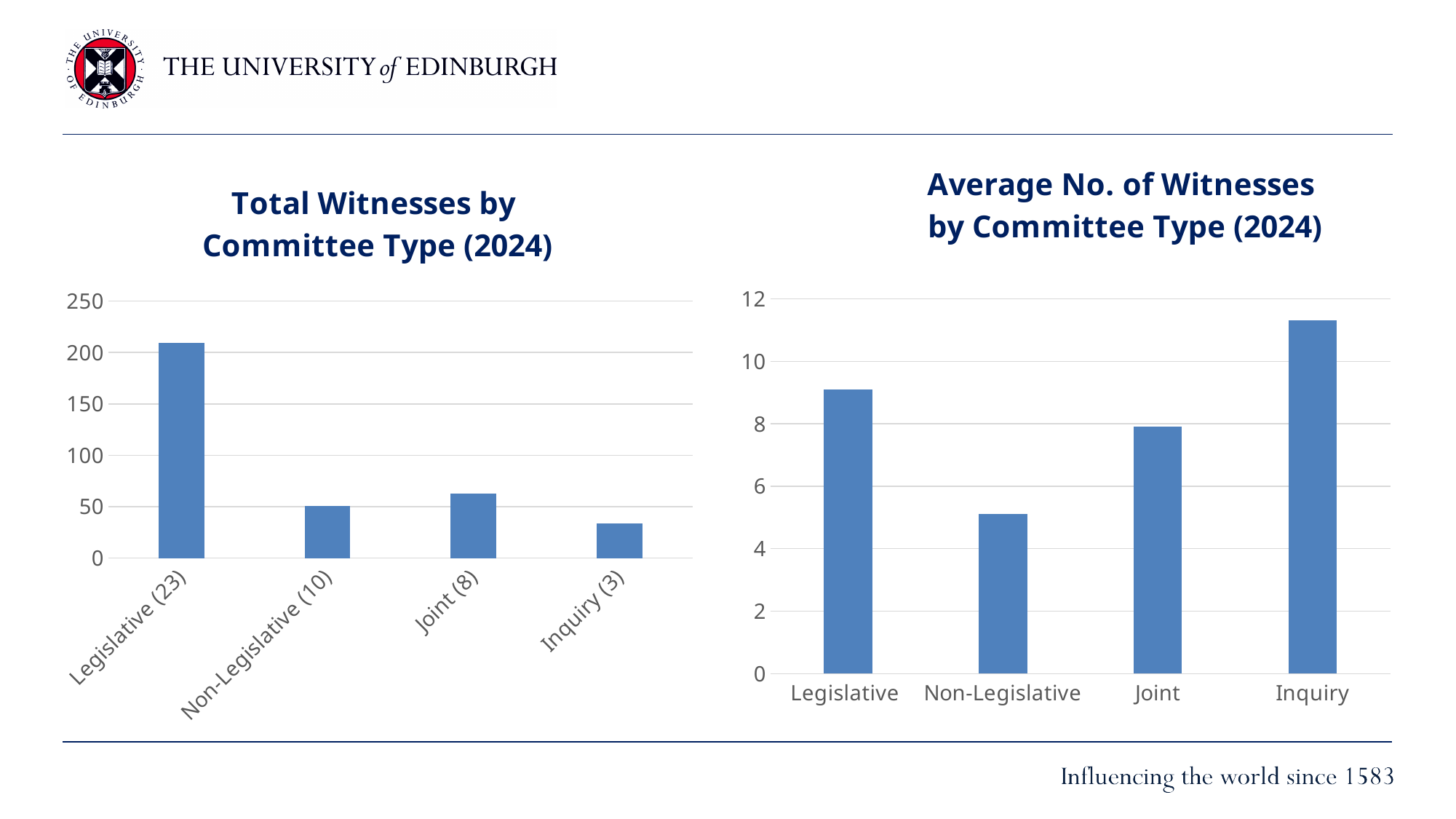
How many committee types are shown in the 'Total Witnesses by Committee Type (2024)' chart? 4 In the 'Average No. of Witnesses by Committee Type (2024)' chart, which committee type has the lowest average? Non-Legislative What kind of chart is the 'Average No. of Witnesses by Committee Type (2024)' chart? Bar chart In the 'Total Witnesses by Committee Type (2024)' chart, is the value for Inquiry (3) greater or less than 50? less In the 'Total Witnesses by Committee Type (2024)' chart, is the value for Legislative (23) greater or less than 200? greater In the 'Average No. of Witnesses by Committee Type (2024)' chart, which committee type has the highest average? Inquiry In the 'Total Witnesses by Committee Type (2024)' chart, which is larger: Joint (8) or Non-Legislative (10)? Joint (8) In the 'Total Witnesses by Committee Type (2024)' chart, is the value for Non-Legislative (10) greater or less than 100? less In the 'Total Witnesses by Committee Type (2024)' chart, which committee type has the highest total? Legislative (23) In the 'Average No. of Witnesses by Committee Type (2024)' chart, which is larger: Legislative or Joint? Legislative In the 'Total Witnesses by Committee Type (2024)' chart, which committee type has the lowest total? Inquiry (3)